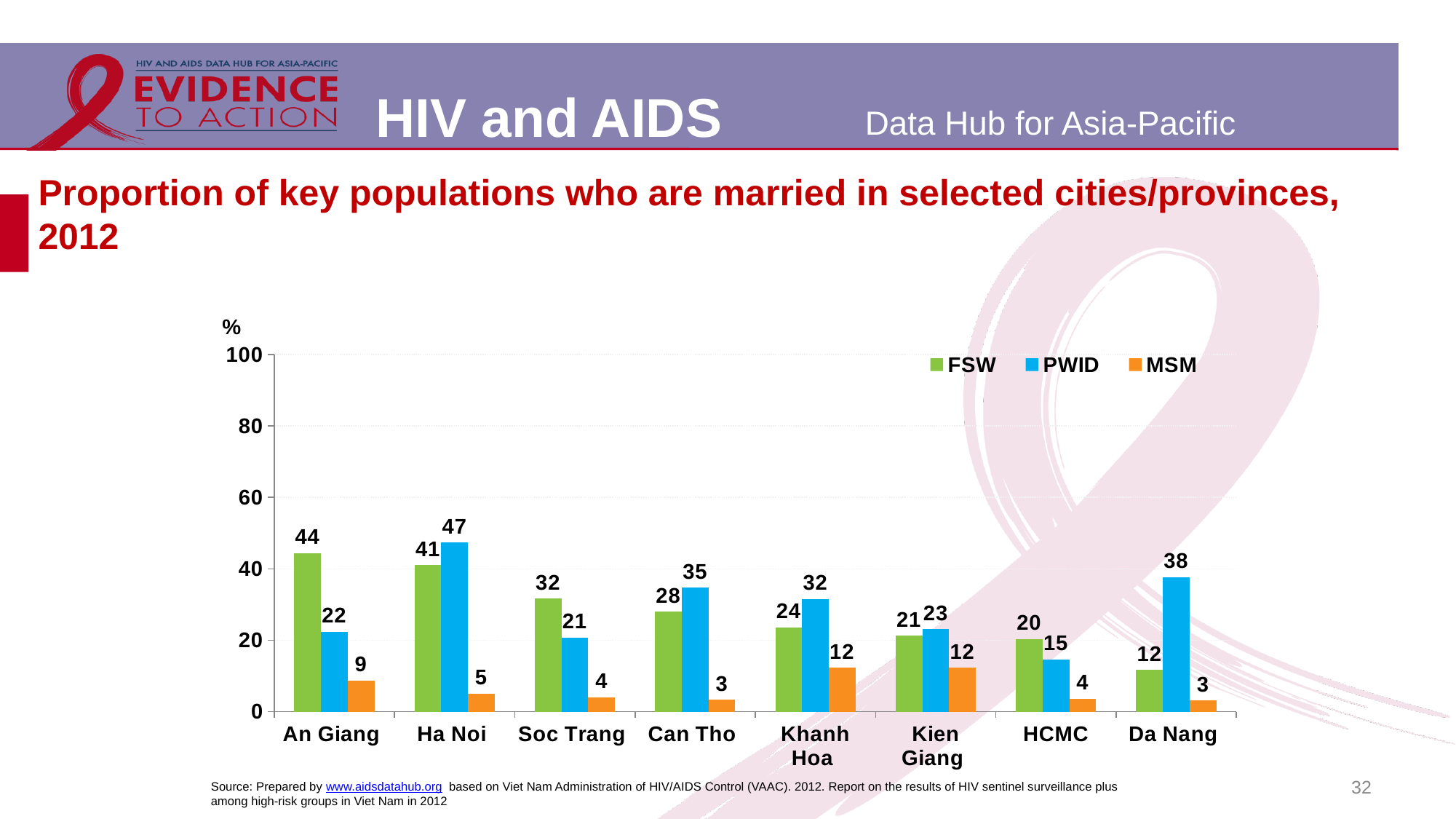
Which city/province has the lowest FSW value? Da Nang What is the PWID value for Da Nang? 38 What is the MSM value for Khanh Hoa? 12 Which city/province has the highest PWID value? Ha Noi Which is larger for Can Tho, the FSW value or the PWID value? PWID How many cities/provinces are shown on the x axis? 8 How many series does the legend list? 3 What is the difference between the PWID and FSW values for Da Nang? 26 What kind of chart is shown on the slide? Bar chart Which series is shown in orange in the legend? MSM What is the difference between the FSW values for An Giang and HCMC? 24 What is the FSW value for An Giang? 44